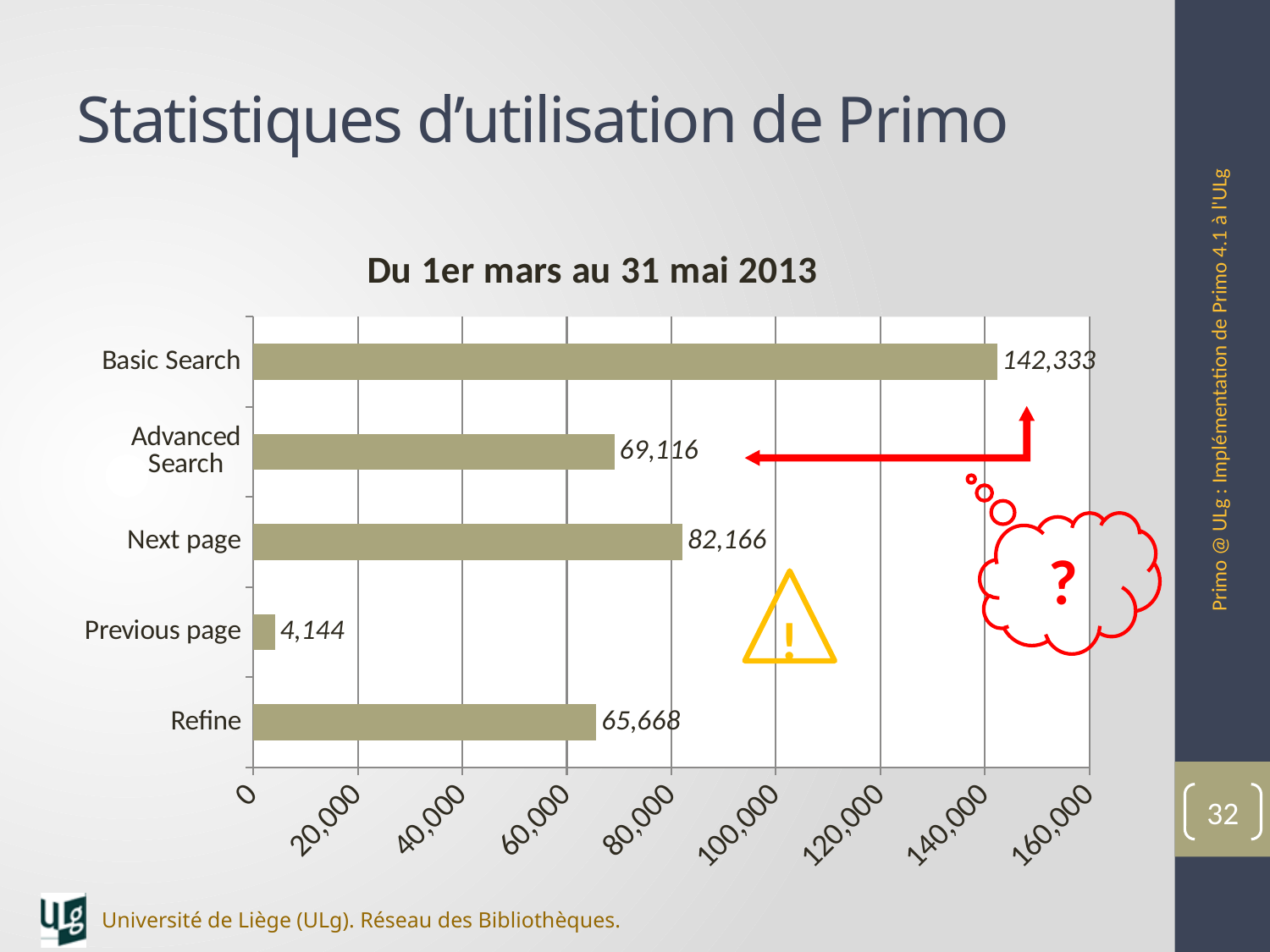
Which category has the lowest value? Previous page Which category has the highest value? Basic Search What is the difference between Basic Search and Advanced Search? 73,217 What is the value for Refine? 65,668 What is the difference between Next page and Previous page? 78,022 How many categories are shown in the chart? 5 Is the value for Next page greater or less than 80,000? greater What is the value for Previous page? 4,144 What is the value for Advanced Search? 69,116 What is the value for Basic Search? 142,333 Which is larger, Next page or Refine? Next page What is the title of the chart? Du 1er mars au 31 mai 2013